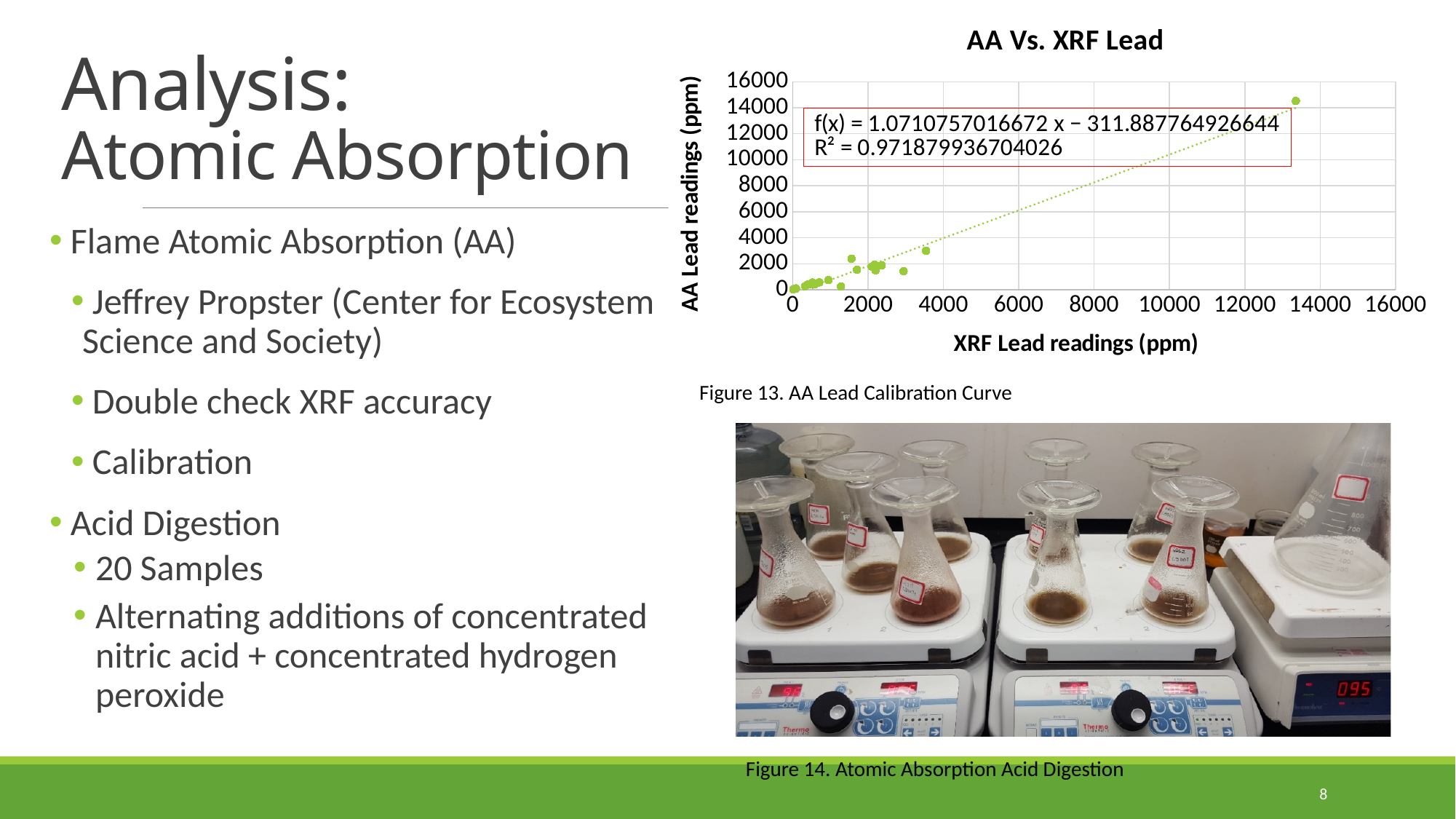
Is the XRF Lead reading of the highest point on the chart greater or less than 12000? greater Is the AA Lead reading of the highest point on the chart greater or less than 16000? less What is the title of the chart? AA Vs. XRF Lead What kind of chart is shown on the slide? scatter chart Is the AA Lead reading of the highest point on the chart greater or less than 12000? greater What is the label of the x axis of the chart? XRF Lead readings (ppm) Do the AA Lead readings rise or fall as the XRF Lead readings increase along the x axis? rise What is the highest tick value shown on the y axis of the chart? 16000 What is the slope of the trendline equation printed on the chart? 1.0710757016672 What is the R² value printed on the chart's trendline label? 0.971879936704026